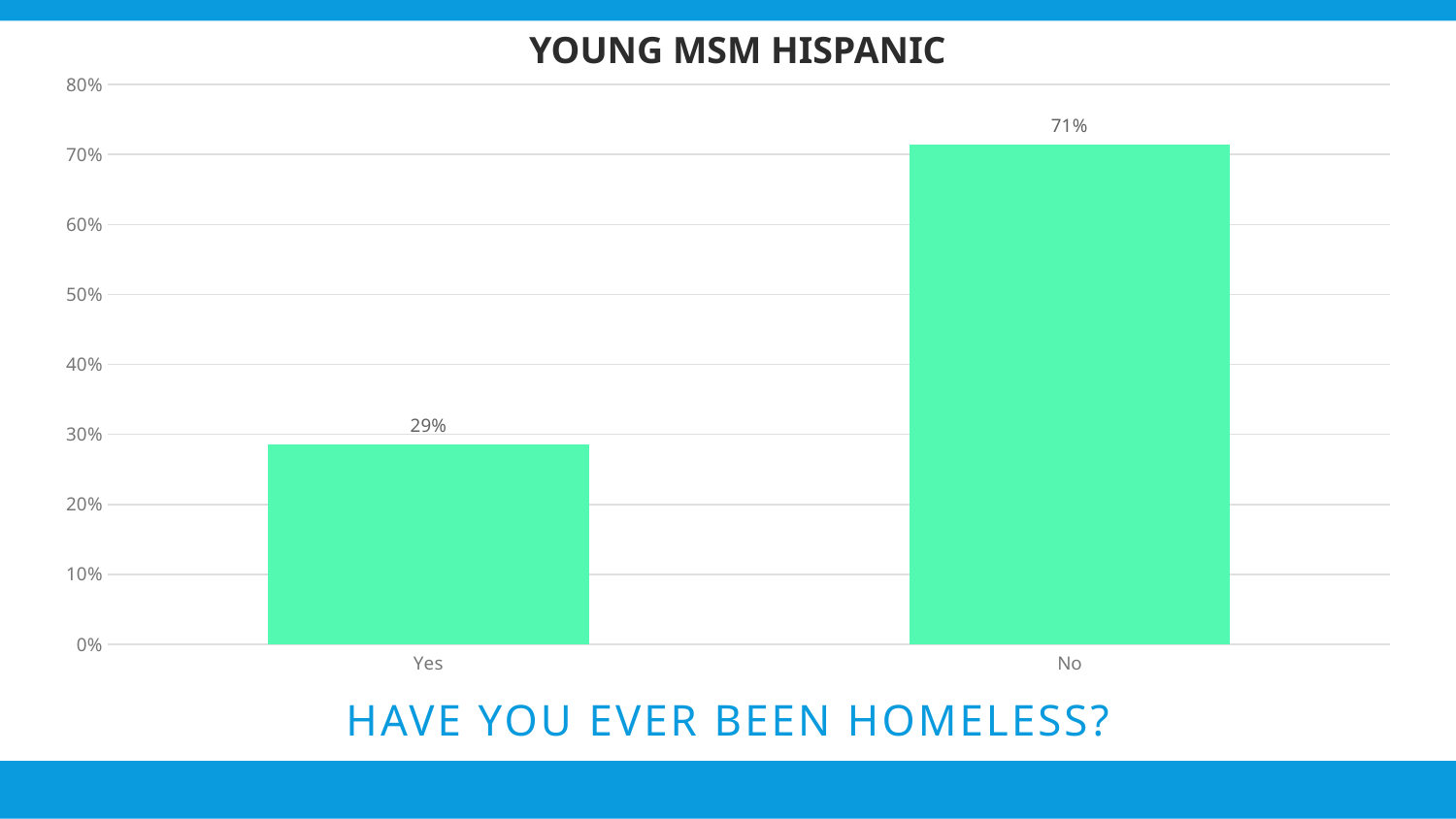
Is the value for "Yes" greater or less than 30%? less What is the highest value shown on the y axis? 80% Which category has the lowest value? Yes What is the difference between the values for "No" and "Yes"? 42% How many categories are shown on the x axis? 2 What kind of chart is shown on the slide? bar chart What is the title of the chart? YOUNG MSM HISPANIC Which category has the highest value? No What is the value for "No"? 71% Which is larger, the value for "Yes" or the value for "No"? No What is the value for "Yes"? 29% Is the value for "No" greater or less than 70%? greater